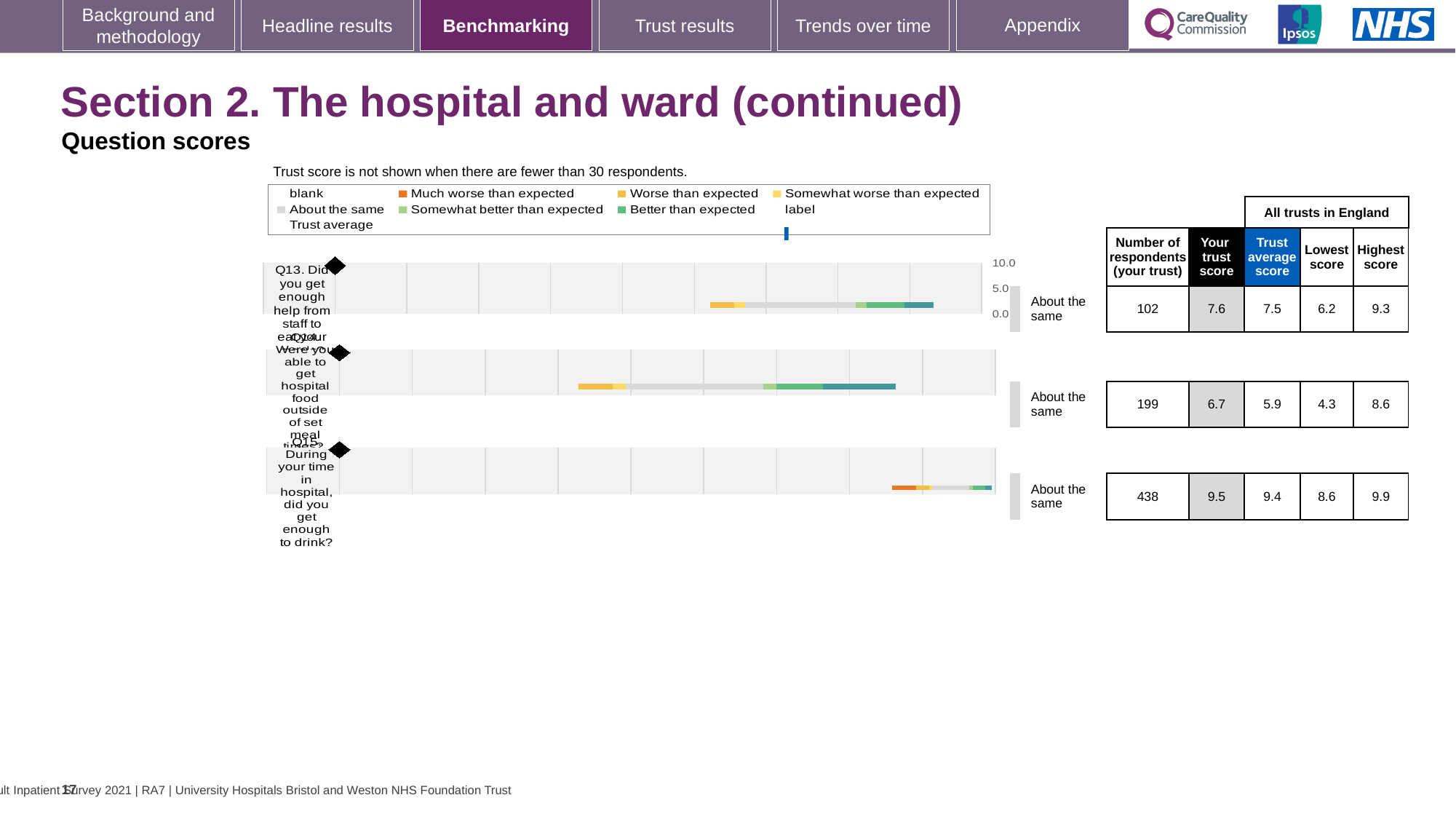
What benchmark category is shown for Q15? About the same What is the trust average score for Q14? 5.9 Which question has the fewest respondents? Q13 How many questions (categories) are plotted on the slide? 3 Which question has the highest 'Your trust score'? Q15 What kind of chart is used to show the question scores on this slide? bar chart What is the 'Your trust score' for Q13 (Did you get enough help from staff to eat your meals?)? 7.6 Is the 'Your trust score' for Q13 higher or lower than the trust average score for Q13? higher What is the number of respondents for Q14 (Were you able to get hospital food outside of set meal times?)? 199 What is the highest score across all trusts in England for Q15 (did you get enough to drink?)? 9.9 What is the lowest score across all trusts in England for Q13? 6.2 What is the difference between the highest score and the lowest score for Q14? 4.3